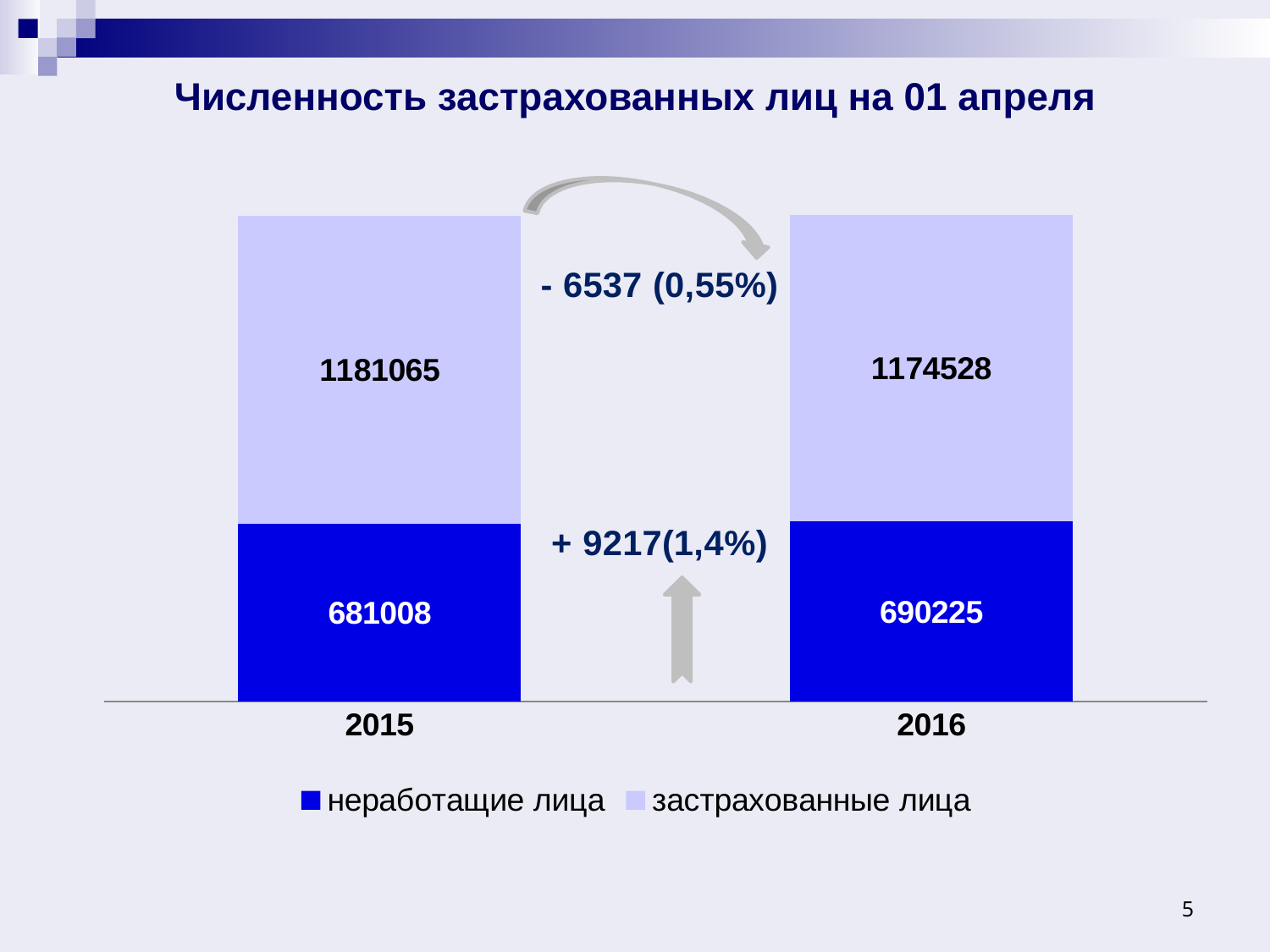
What is the difference between the неработащие лица values for 2016 and 2015? 9217 What kind of chart is shown on the slide? Stacked bar chart What is the value for застрахованные лица in 2016? 1174528 What is the value for застрахованные лица in 2015? 1181065 What is the difference between the застрахованные лица values for 2015 and 2016? 6537 How many categories are shown on the x axis? 2 What is the value for неработащие лица in 2015? 681008 What is the total of the stacked bar for 2015? 1862073 How many series does the legend list? 2 Which year has the higher value for застрахованные лица, 2015 or 2016? 2015 Which year has the higher value for неработащие лица, 2015 or 2016? 2016 What is the value for неработащие лица in 2016? 690225